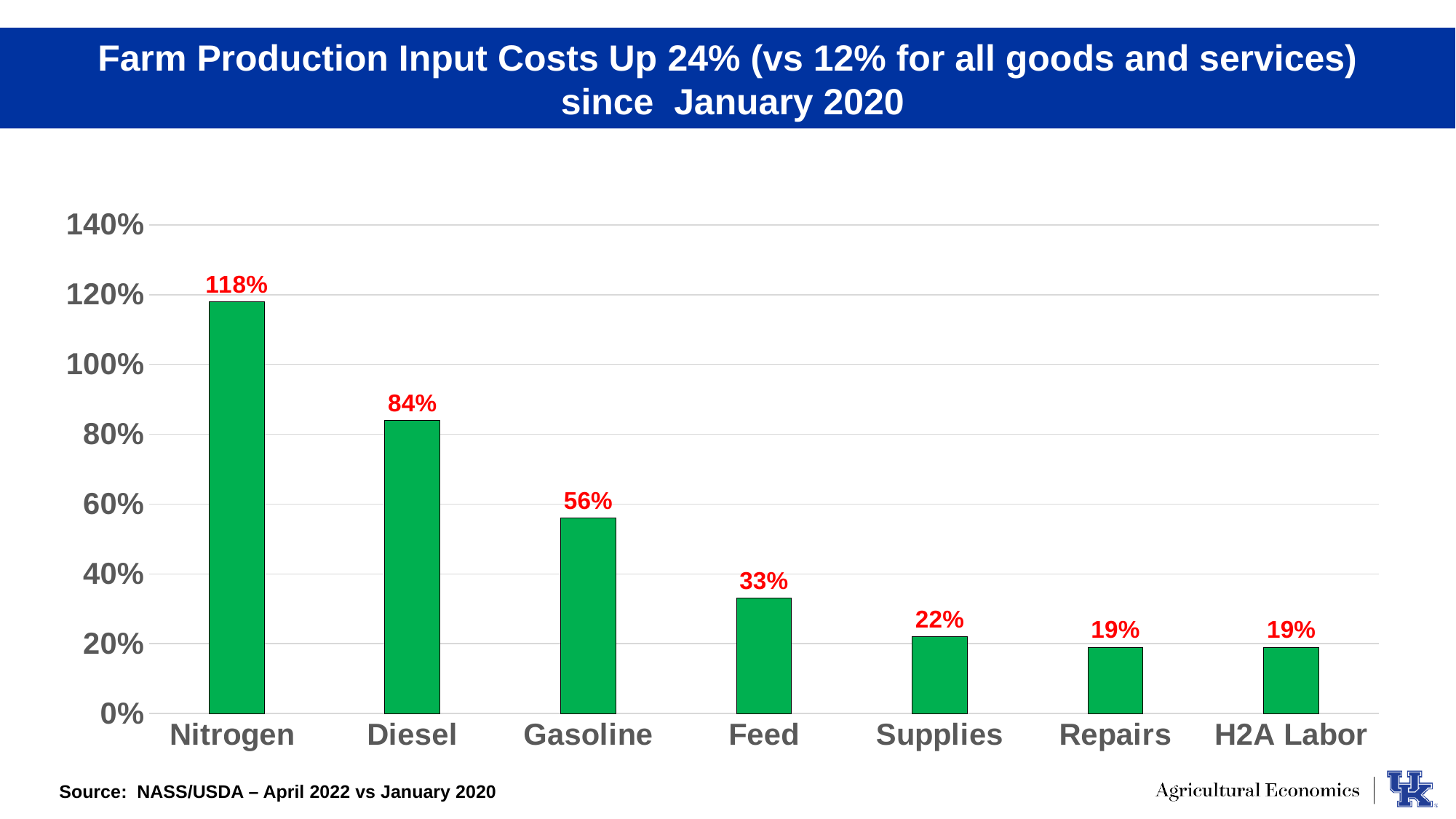
Do the values rise or fall from left to right along the x axis? fall What is the difference between the values for Nitrogen and Diesel? 34% Which is larger, the value for Gasoline or the value for Feed? Gasoline What is the value for Supplies? 22% What is the value for Feed? 33% How many categories are shown on the x axis? 7 What is the value for Diesel? 84% Is the value for Diesel greater or less than 100%? less What is the value for Nitrogen? 118% Which category has the highest value? Nitrogen What kind of chart is shown on the slide? bar chart What is the difference between the values for Gasoline and Feed? 23%